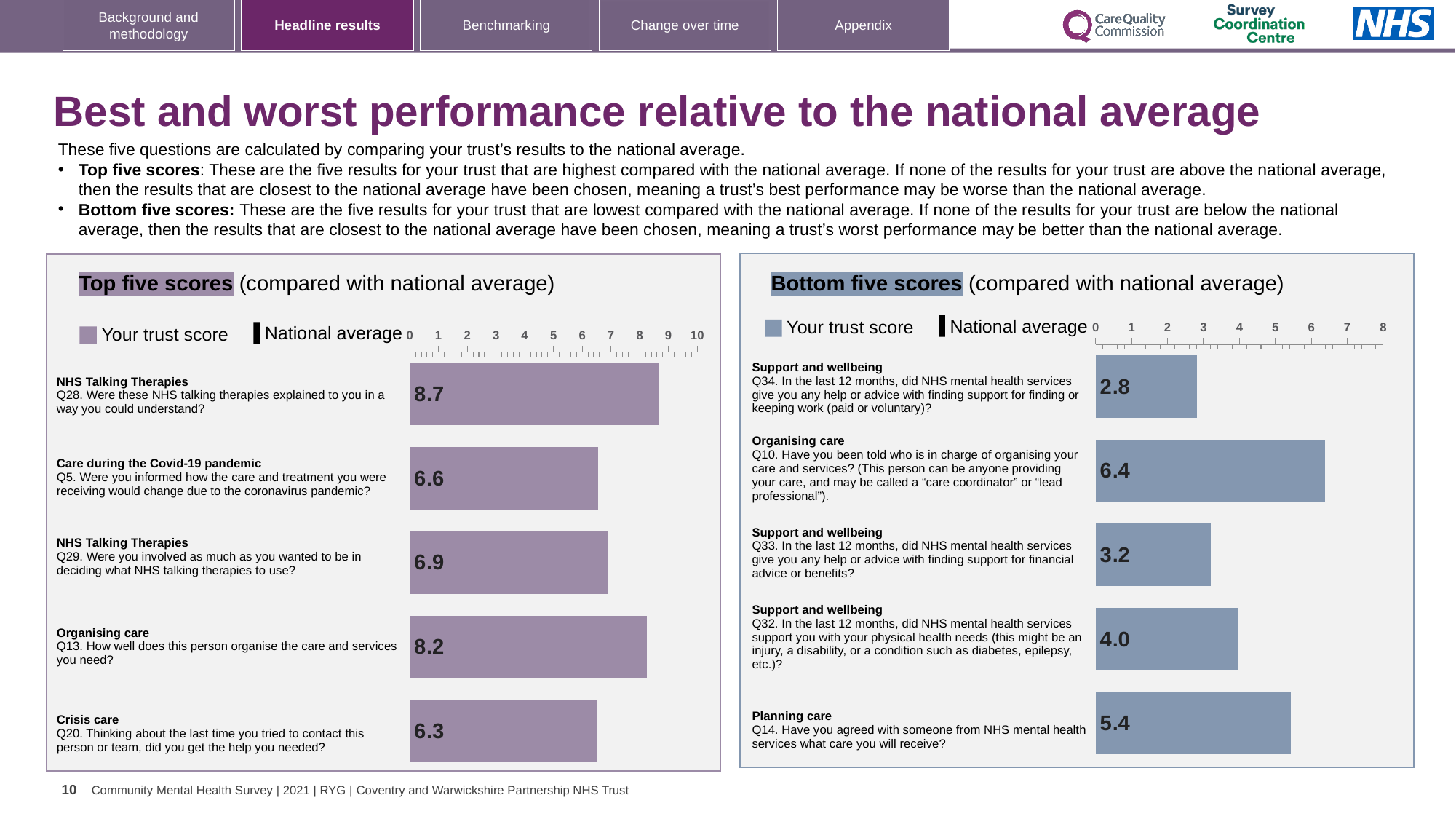
In the Top five scores chart, which question has the highest trust score? Q28 (NHS Talking Therapies) In the Bottom five scores chart, which question has the lowest trust score? Q34 (Support and wellbeing) In the Top five scores chart, what is the difference between the trust scores for Q28 and Q20? 2.4 What type of chart is used for the Top five scores? Bar chart In the Bottom five scores chart, which has the larger trust score: Q33 or Q32? Q32 In the Bottom five scores chart, which question has the highest trust score? Q10 (Organising care) In the Top five scores chart, what is the trust score for Q20 (Crisis care)? 6.3 In the Top five scores chart, what is the trust score for Q28 (Were these NHS talking therapies explained to you in a way you could understand?)? 8.7 In the Bottom five scores chart, what is the trust score for Q14 (Planning care)? 5.4 How many series does the legend of the Top five scores chart list? 2 In the Bottom five scores chart, what is the trust score for Q34 (help or advice with finding support for finding or keeping work)? 2.8 How many bars are plotted in the Bottom five scores chart? 5